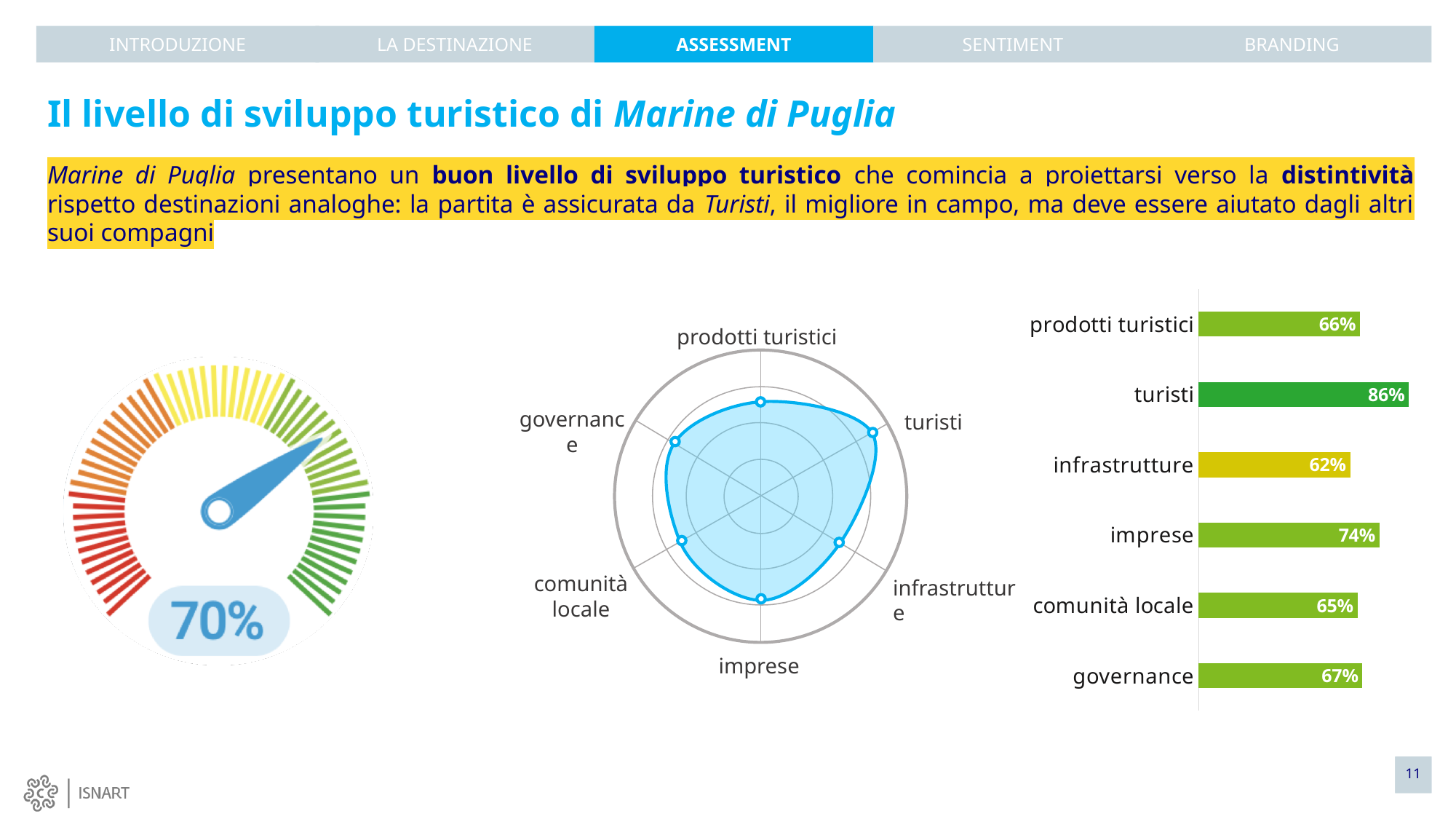
How many categories are shown in the bar chart on the right? 6 In the bar chart on the right, what is the value for turisti? 86% In the bar chart on the right, what is the value for infrastrutture? 62% In the bar chart on the right, which is larger: the value for governance or the value for prodotti turistici? governance In the bar chart on the right, which category has the lowest value? infrastrutture What kind of chart is the chart in the centre of the slide? radar chart In the bar chart on the right, what is the difference between the values for turisti and imprese? 12% In the bar chart on the right, what is the value for comunità locale? 65% How many categories are shown on the radar chart in the centre of the slide? 6 What percentage is displayed on the gauge on the left of the slide? 70% In the bar chart on the right, which category has the highest value? turisti What kind of chart is the chart on the right of the slide? bar chart